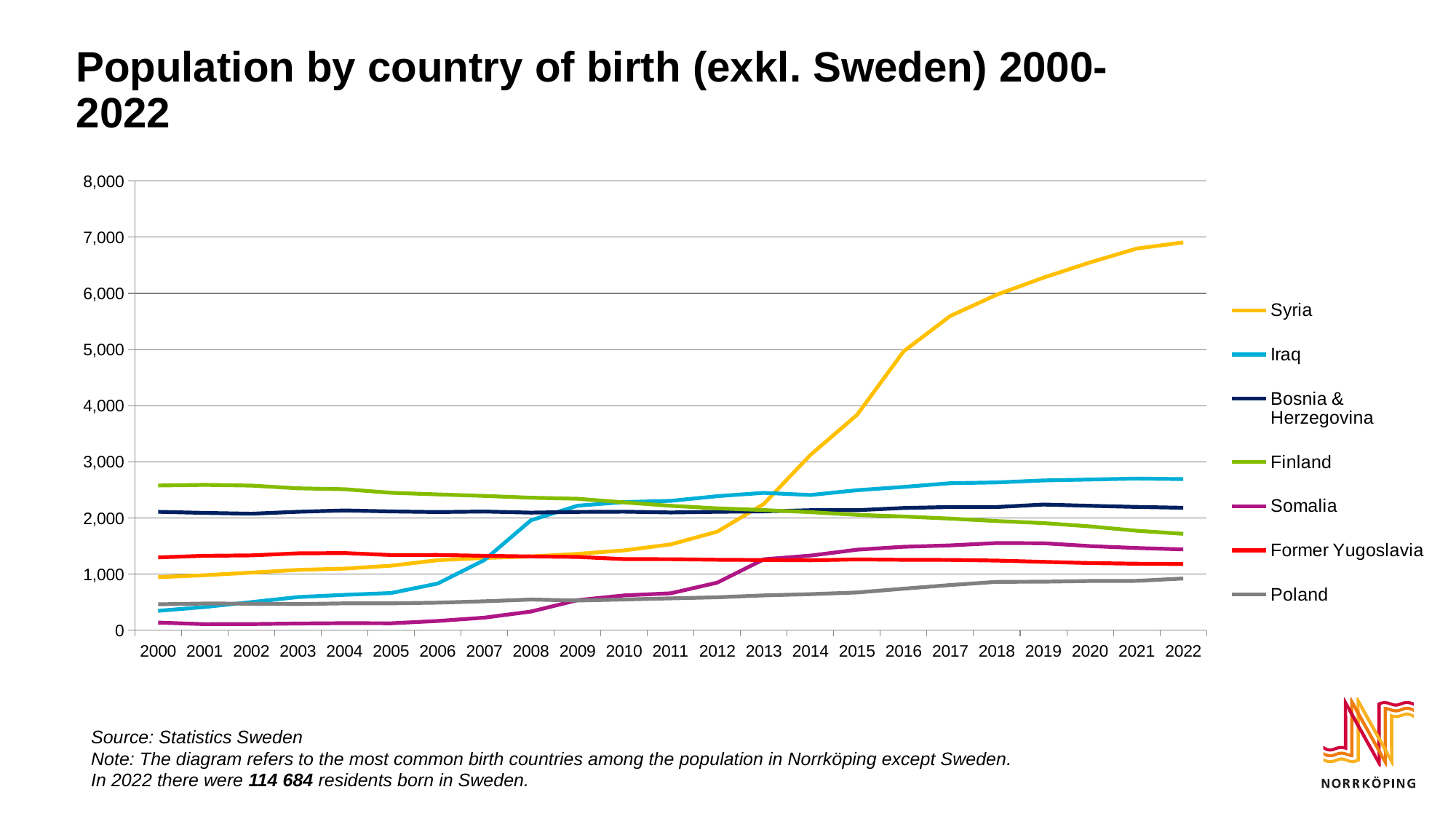
Is the value for Somalia in 2000 greater or less than 1,000? less How many series does the legend list? 7 Is the value for Finland in 2022 greater or less than 2,000? less Which country has the lowest population in 2022? Poland Does the Finland line rise or fall from 2000 to 2022? fall Which country has the highest population in 2022? Syria In 2022, which is larger: the value for Iraq or the value for Bosnia & Herzegovina? Iraq What is the title of the chart? Population by country of birth (exkl. Sweden) 2000-2022 How many years are plotted along the x axis? 23 Is the value for Syria in 2022 greater or less than 6,000? greater Which country has the highest population in 2000? Finland What kind of chart is shown on the slide? line chart